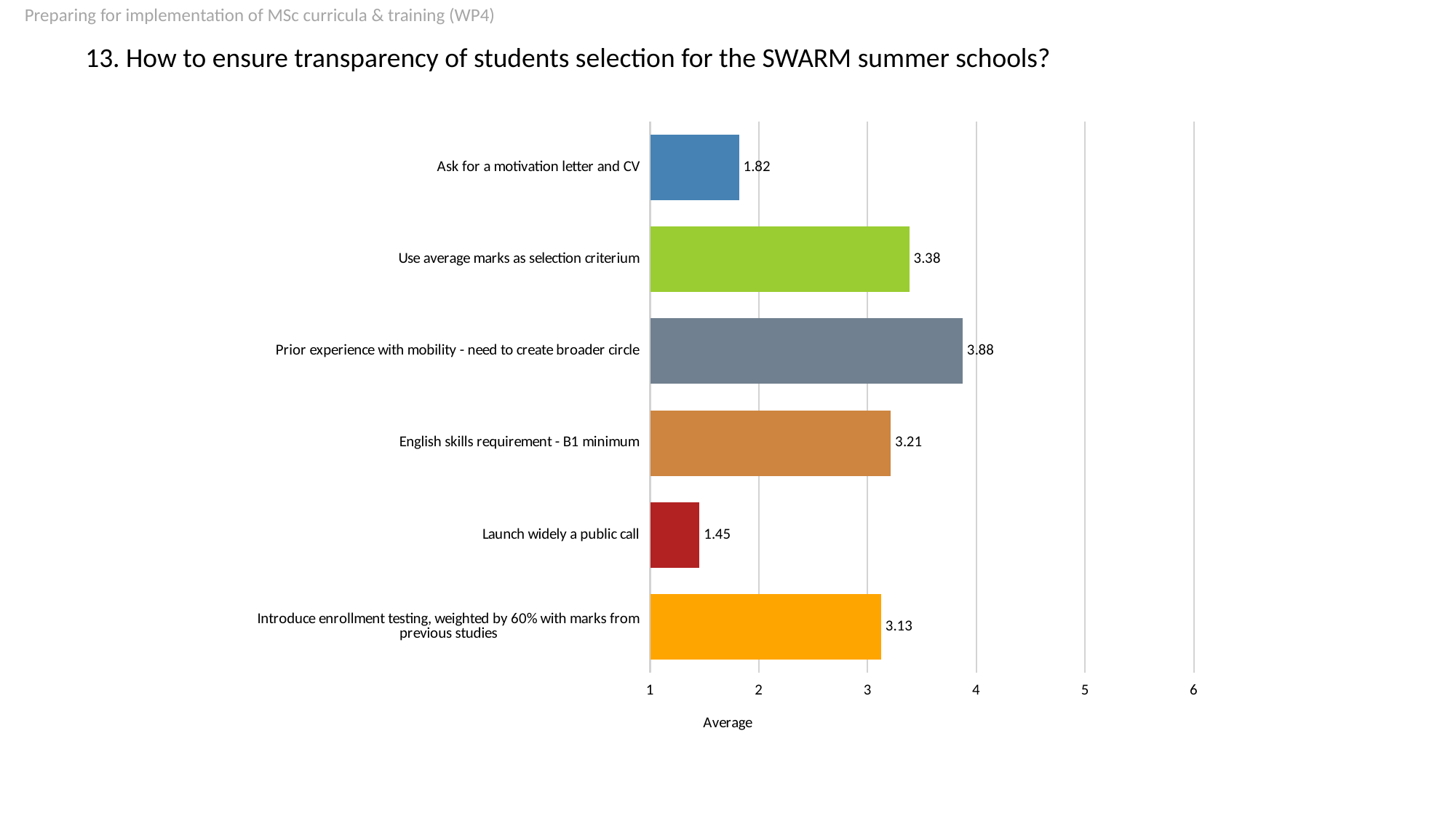
What is the average value for 'Introduce enrollment testing, weighted by 60% with marks from previous studies'? 3.13 What is the average value for 'English skills requirement - B1 minimum'? 3.21 What is the label of the horizontal axis? Average What is the average value for 'Ask for a motivation letter and CV'? 1.82 Which option has the lowest average value? Launch widely a public call What kind of chart is shown on the slide? bar chart What is the difference between the values for 'Prior experience with mobility - need to create broader circle' and 'Launch widely a public call'? 2.43 How many options are shown in the chart? 6 What is the average value for 'Use average marks as selection criterium'? 3.38 Which has a larger value: 'Use average marks as selection criterium' or 'English skills requirement - B1 minimum'? Use average marks as selection criterium Is the value for 'Ask for a motivation letter and CV' greater or less than 2? less Which option has the highest average value? Prior experience with mobility - need to create broader circle